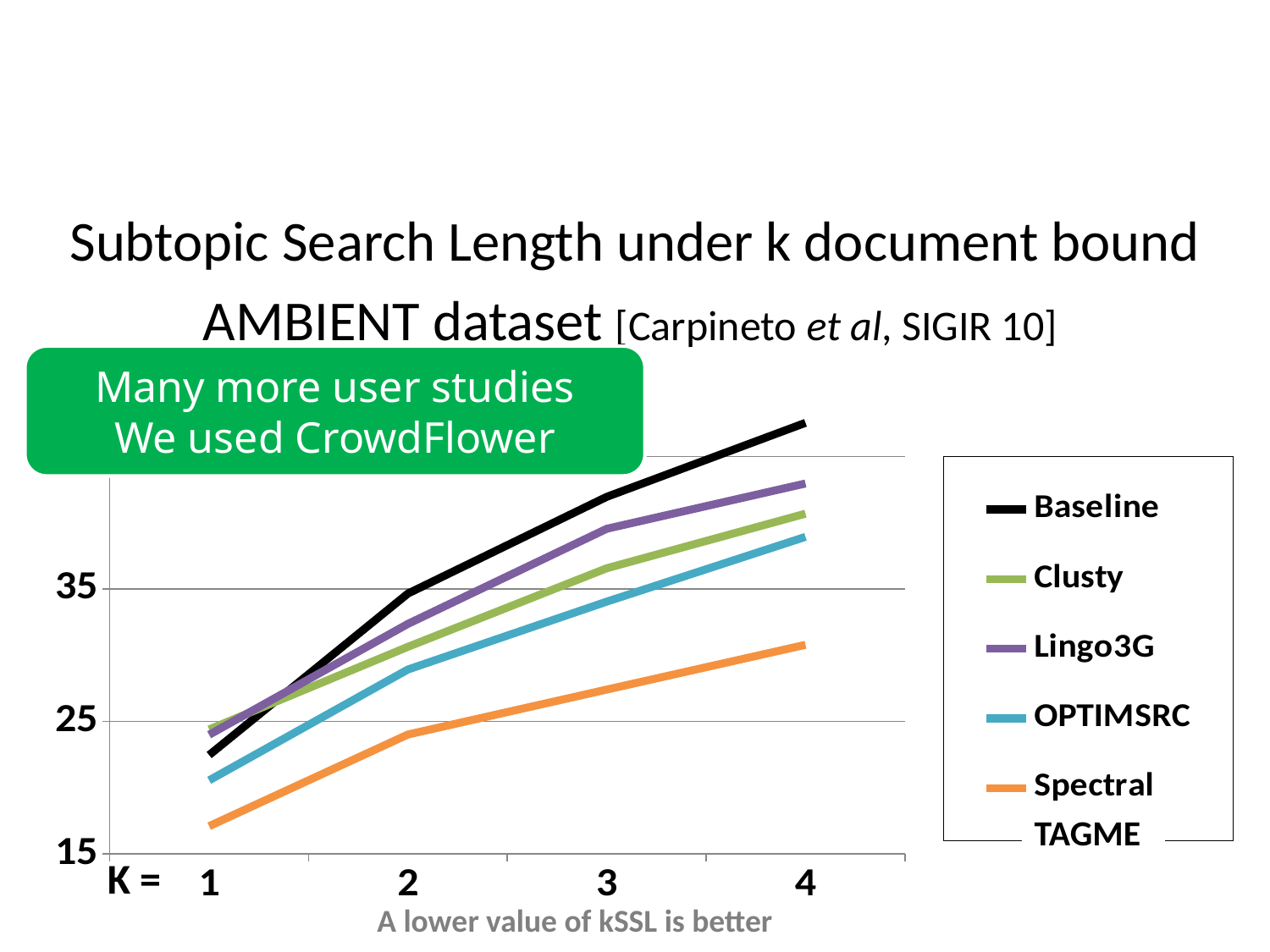
Is the value for Baseline at K = 3 greater or less than 35? greater What note is printed below the x axis of the chart? A lower value of kSSL is better Which series has the lowest value at K = 1? Spectral TAGME Which series has the highest value at K = 4? Baseline Is the value for Spectral TAGME at K = 1 greater or less than 25? less Is the value for OPTIMSRC at K = 4 greater or less than 35? greater How many values of K are plotted along the x axis? 4 Does the Baseline line rise or fall as K increases from 1 to 4? rises At K = 2, which is larger: OPTIMSRC or Spectral TAGME? OPTIMSRC Which series has the lowest value at K = 4? Spectral TAGME What kind of chart is shown on the slide? line chart How many series does the legend list? 5